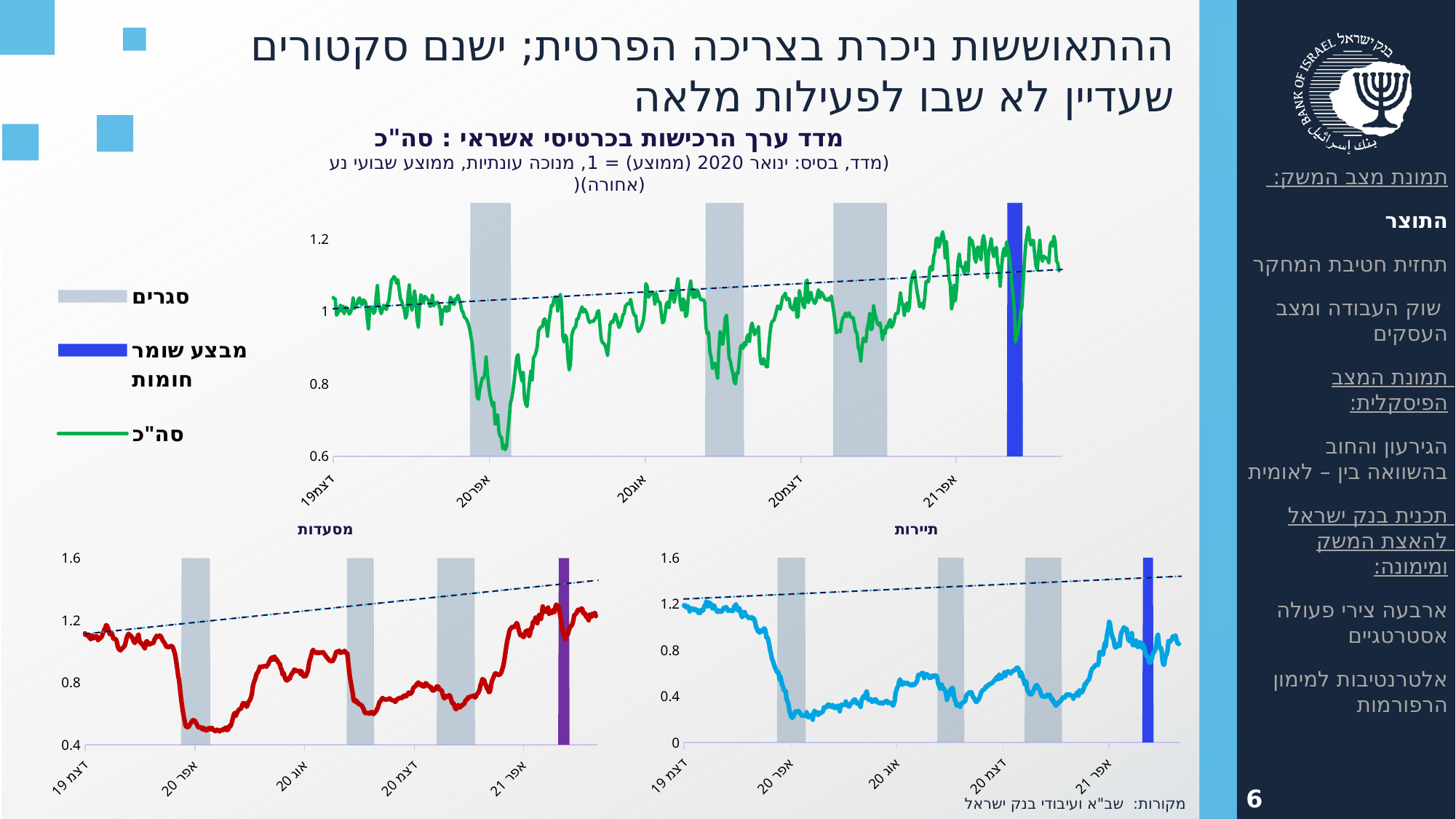
How many labelled ticks are on the x axis of the bottom-right chart (תיירות)? 5 In the top chart (סה"כ), how many shaded lockdown (סגרים) periods are marked? 3 In the bottom-left chart (מסעדות), is the value of the red line at דצמ 19 greater or less than 0.8? greater What kind of chart is the top chart titled סה"כ? line chart Which of the two bottom charts, מסעדות or תיירות, shows the deeper drop around אפר 20? תיירות In the bottom-right chart (תיירות), is the lowest value of the blue line around אפר 20 greater or less than 0.4? less In the bottom-left chart (מסעדות), is the lowest value of the red line around אפר 20 greater or less than 0.8? less In the top chart (סה"כ), does the dashed trend line rise or fall from דצמ 19 to אפר 21? rise How many entries does the legend on the left of the slide list? 3 What colour is the line in the bottom-left chart (מסעדות)? red